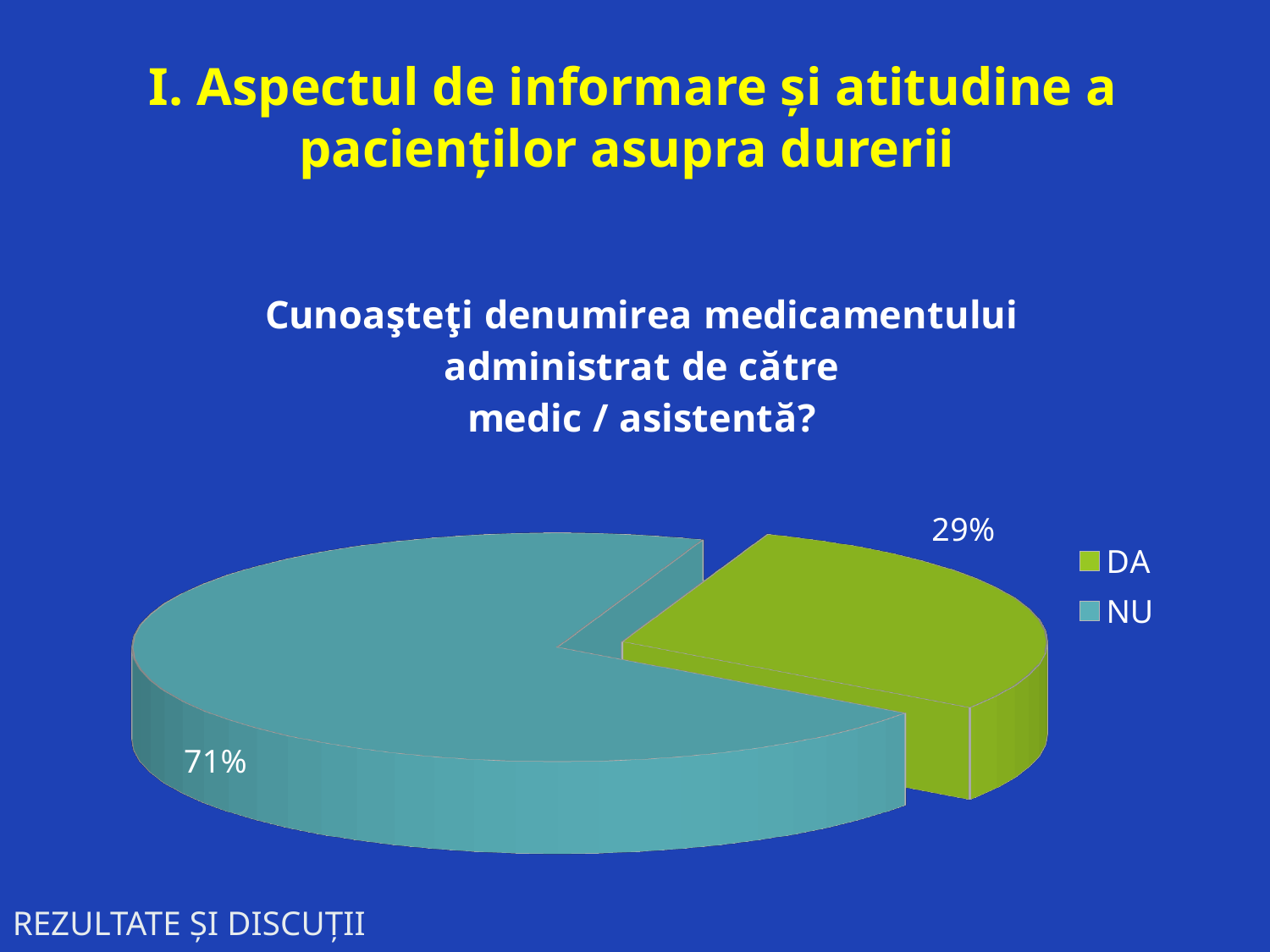
What percentage of the pie chart is labelled DA? 29% How many entries does the legend list? 2 What colour is the DA slice in the pie chart? Green What percentage of the pie chart is labelled NU? 71% What question does the chart title ask? Cunoaşteţi denumirea medicamentului administrat de către medic / asistentă? Which category has the smallest share of the pie chart? DA How many categories does the pie chart show? 2 What kind of chart is shown on the slide? Pie chart Which slice is larger, DA or NU? NU What share of the pie does the DA slice represent? 29% Which category has the largest share of the pie chart? NU What is the difference in percentage points between the NU and DA slices? 42